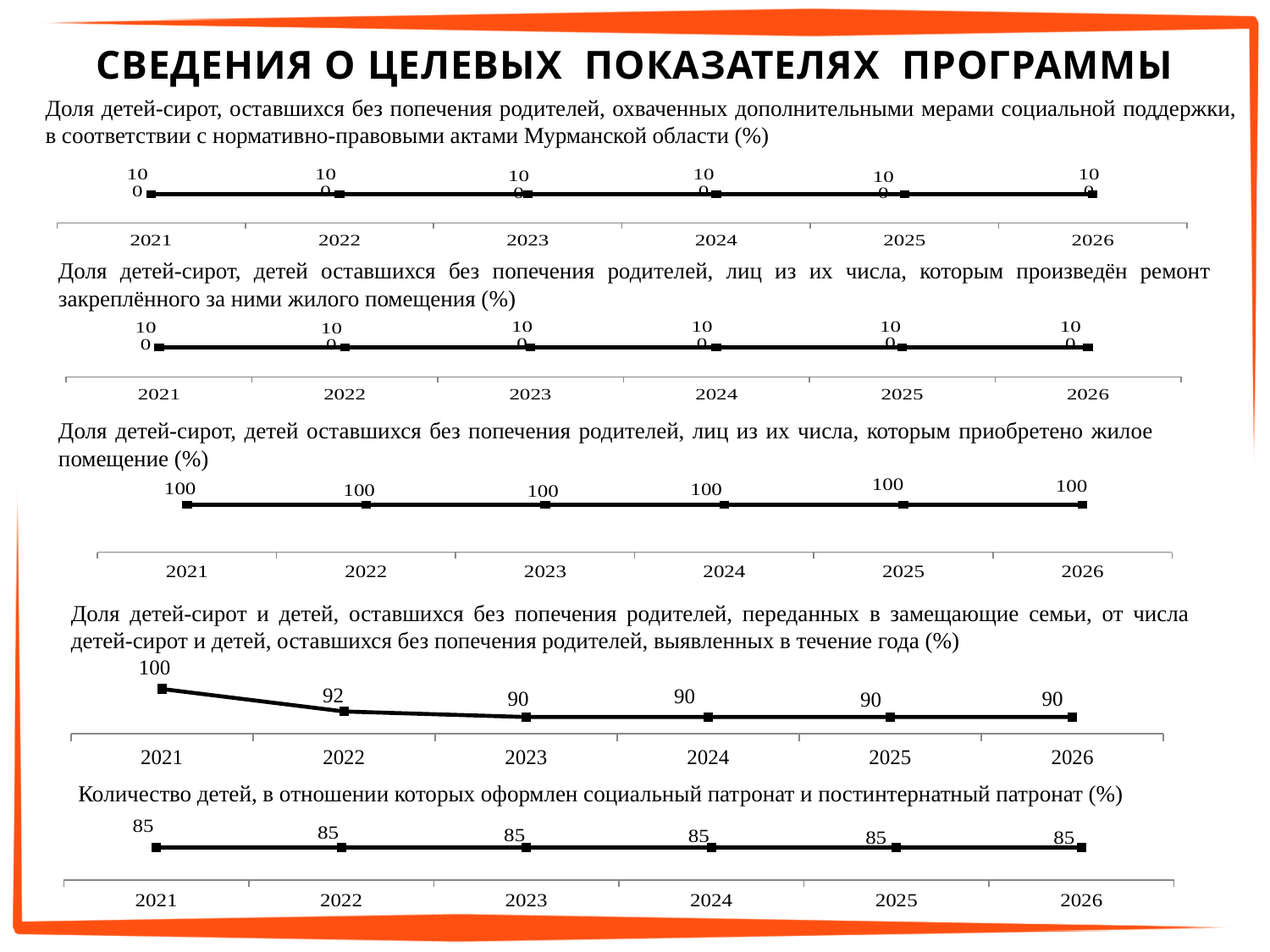
In the chart titled 'Доля детей-сирот, детей оставшихся без попечения родителей, лиц из их числа, которым приобретено жилое помещение (%)', what is the value for 2026? 100 In the chart titled 'Доля детей-сирот и детей, оставшихся без попечения родителей, переданных в замещающие семьи...', do the values rise or fall from 2021 to 2026? fall In the chart titled 'Доля детей-сирот и детей, оставшихся без попечения родителей, переданных в замещающие семьи...', what is the value for 2022? 92 In the chart titled 'Доля детей-сирот и детей, оставшихся без попечения родителей, переданных в замещающие семьи...', what is the difference between the values for 2021 and 2026? 10 In the chart titled 'Доля детей-сирот и детей, оставшихся без попечения родителей, переданных в замещающие семьи...', which year has the highest value? 2021 How many years are plotted in the chart titled 'Количество детей, в отношении которых оформлен социальный патронат и постинтернатный патронат (%)'? 6 In the chart titled 'Количество детей, в отношении которых оформлен социальный патронат и постинтернатный патронат (%)', what is the value for 2024? 85 In the chart titled 'Количество детей, в отношении которых оформлен социальный патронат и постинтернатный патронат (%)', do the values rise, fall or stay constant from 2021 to 2026? stay constant What kind of chart is the bottom chart titled 'Количество детей, в отношении которых оформлен социальный патронат и постинтернатный патронат (%)'? line chart In the chart titled 'Доля детей-сирот и детей, оставшихся без попечения родителей, переданных в замещающие семьи...', what is the value for 2021? 100 In the chart titled 'Доля детей-сирот и детей, оставшихся без попечения родителей, переданных в замещающие семьи...', which is larger, the value for 2021 or the value for 2023? 2021 In the chart titled 'Доля детей-сирот и детей, оставшихся без попечения родителей, переданных в замещающие семьи...', what is the difference between the values for 2021 and 2022? 8